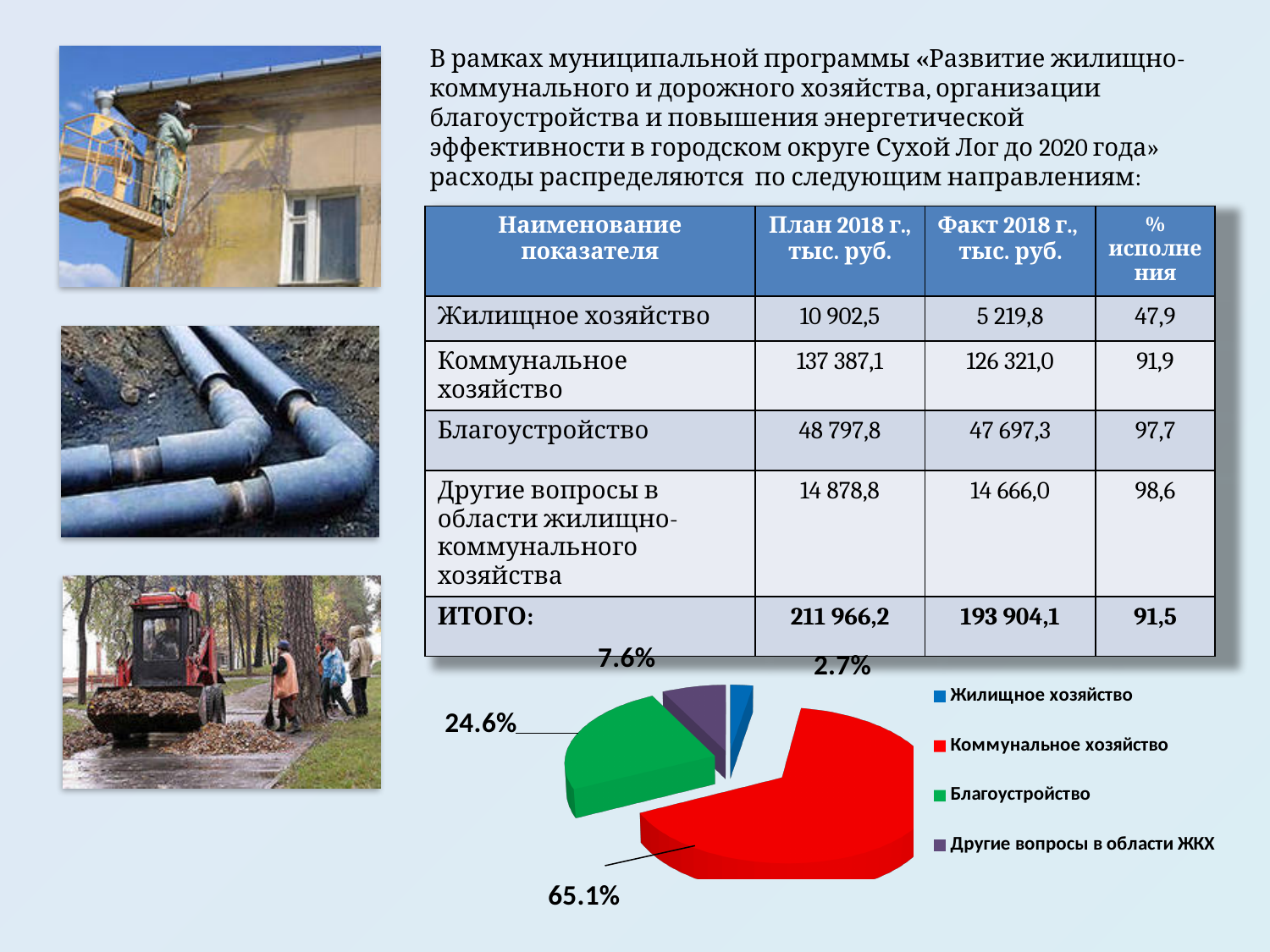
In the pie chart, which is larger: Благоустройство or Другие вопросы в области ЖКХ? Благоустройство What share of the pie chart does Другие вопросы в области ЖКХ have? 7.6% How many slices does the pie chart have? 4 How many entries does the pie chart legend list? 4 What colour is the Благоустройство slice in the pie chart? green What share of the pie chart does Благоустройство have? 24.6% What is the difference in percentage points between the Коммунальное хозяйство and Благоустройство slices in the pie chart? 40.5 What kind of chart is shown at the bottom of the slide? pie chart What share of the pie chart does Жилищное хозяйство have? 2.7% Which category has the smallest slice in the pie chart? Жилищное хозяйство Which category has the largest slice in the pie chart? Коммунальное хозяйство